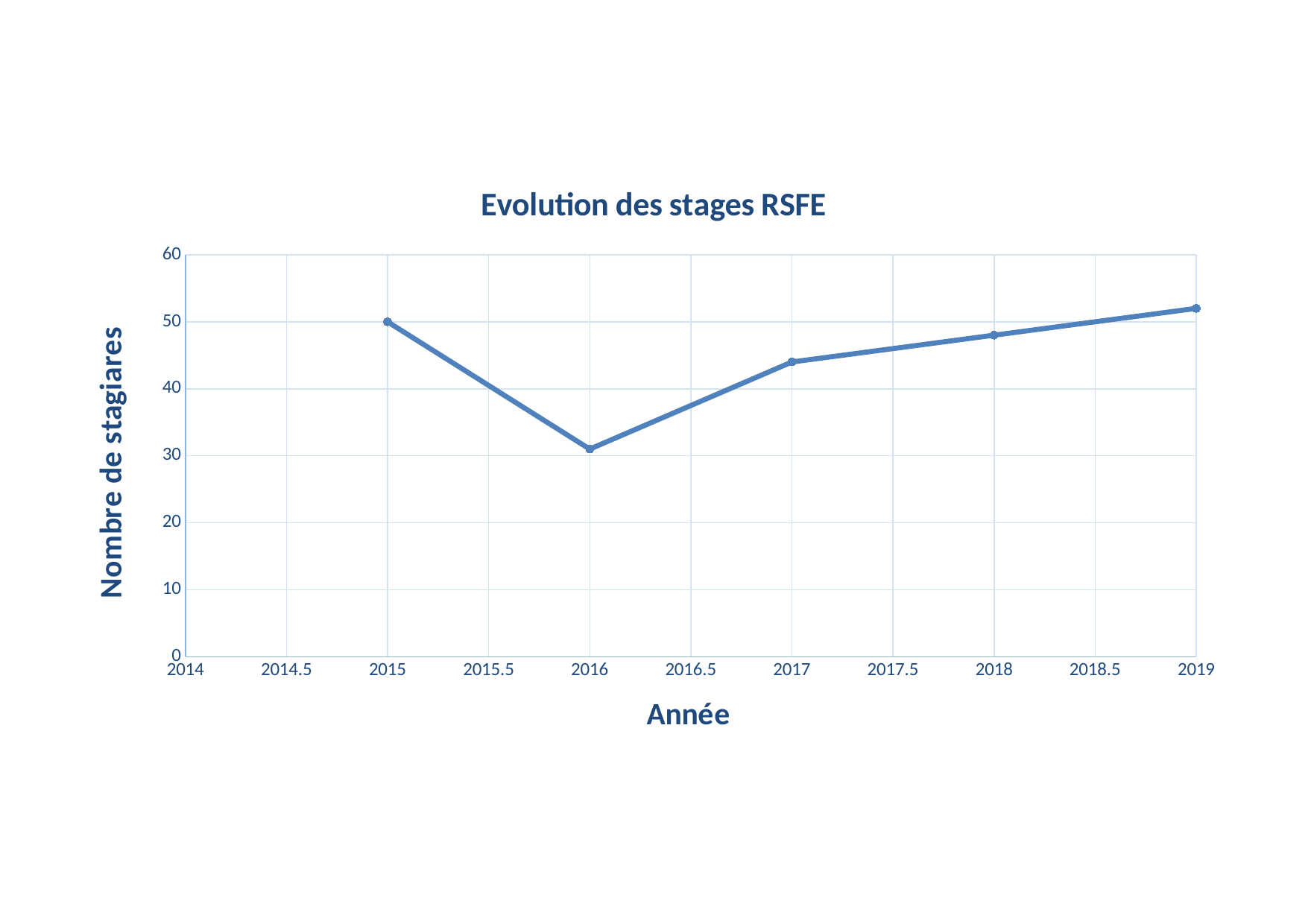
What is the label of the vertical axis? Nombre de stagiares What is the title of the chart? Evolution des stages RSFE Do the values rise or fall from 2016 to 2019? rise What kind of chart is shown on the slide? line chart Is the value for 2019 greater or less than 50? greater Is the value for 2016 greater or less than 40? less Which year has the highest number of stagiaires? 2019 Which is larger, the value for 2015 or the value for 2016? 2015 What is the value for 2015? 50 Which year has the lowest number of stagiaires? 2016 Is the value for 2017 greater or less than 40? greater How many data points are plotted on the line? 5